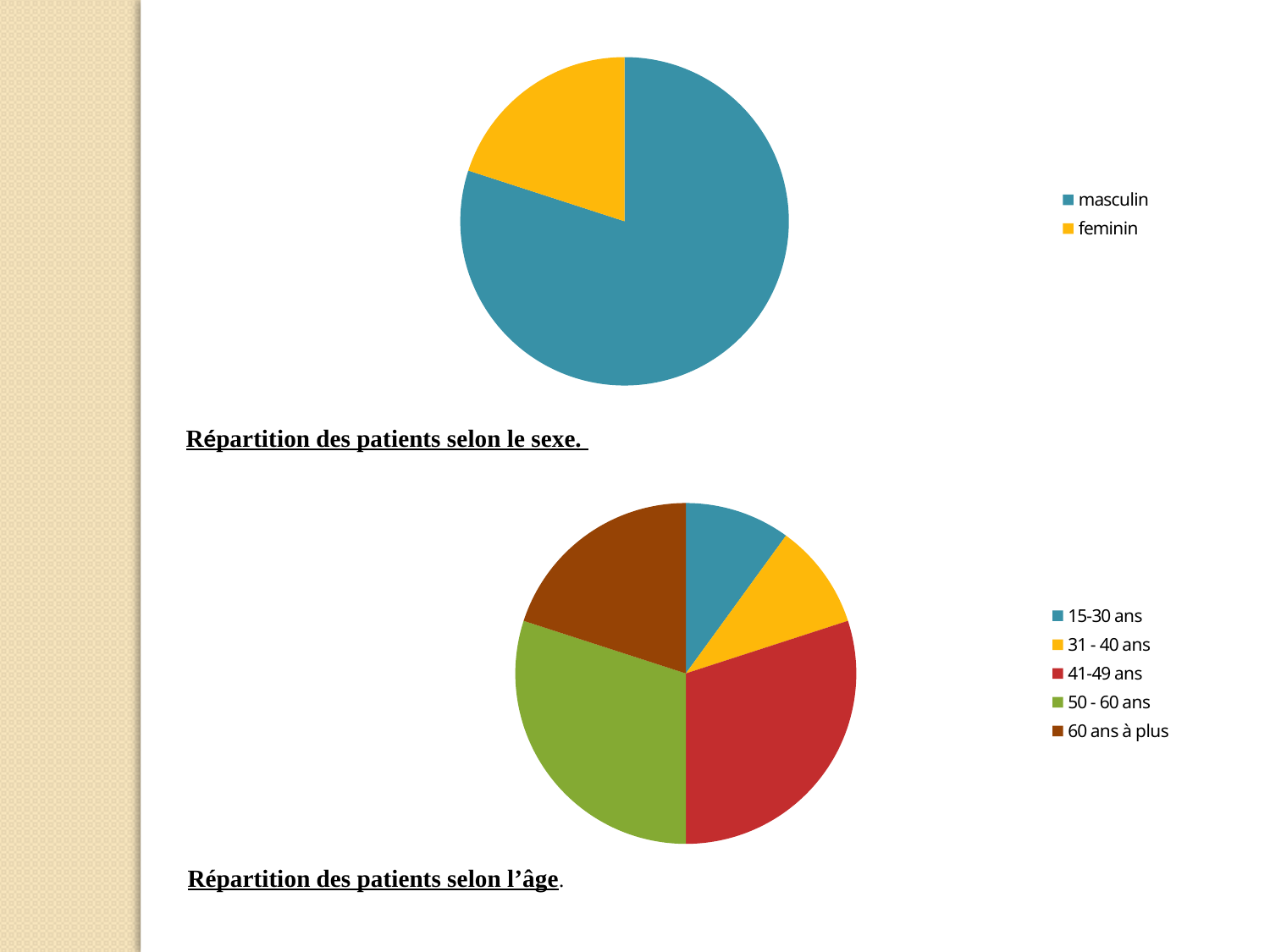
In the chart titled "Répartition des patients selon l'âge", how many age categories does the legend list? 5 What kind of chart is the chart titled "Répartition des patients selon l'âge"? pie chart In the chart titled "Répartition des patients selon l'âge", what colour is the slice for 50 - 60 ans? green In the chart titled "Répartition des patients selon le sexe", which category has the smallest slice? feminin In the chart titled "Répartition des patients selon le sexe", how many categories does the legend list? 2 In the chart titled "Répartition des patients selon l'âge", which slice is larger: 60 ans à plus or 31 - 40 ans? 60 ans à plus What kind of chart is the chart titled "Répartition des patients selon le sexe"? pie chart In the chart titled "Répartition des patients selon l'âge", which slice is larger: 50 - 60 ans or 15-30 ans? 50 - 60 ans In the chart titled "Répartition des patients selon le sexe", what colour is the slice for feminin? yellow In the chart titled "Répartition des patients selon l'âge", which slice is larger: 41-49 ans or 60 ans à plus? 41-49 ans In the chart titled "Répartition des patients selon le sexe", which category has the largest slice? masculin